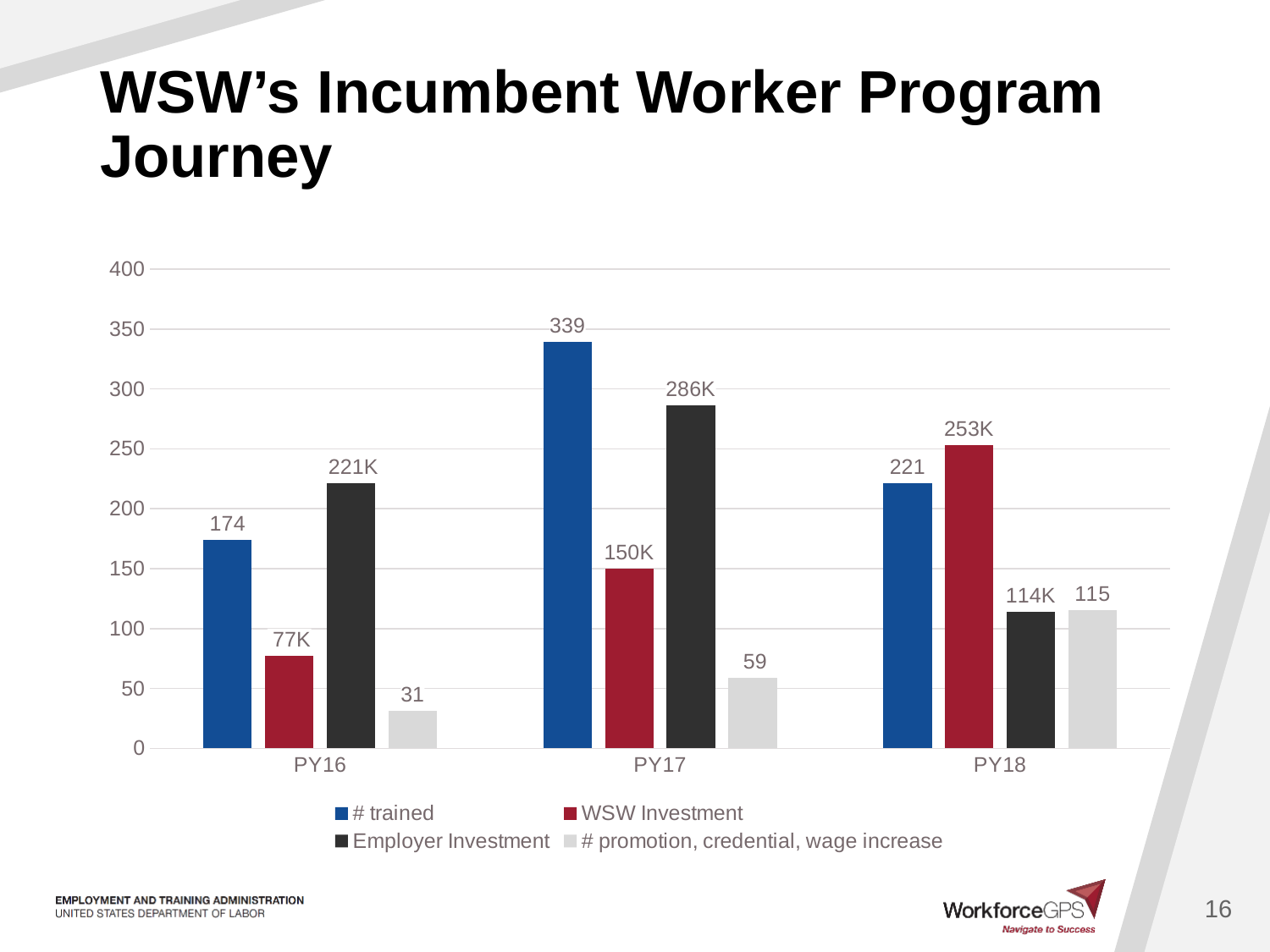
In which program year is the # promotion, credential, wage increase value lowest? PY16 What is the difference in # trained between PY17 and PY16? 165 How many program years are shown on the x axis? 3 What is the Employer Investment value for PY18? 114K What is the value for # trained in PY17? 339 Which is larger, the WSW Investment in PY18 or the Employer Investment in PY18? WSW Investment What is the WSW Investment value for PY16? 77K In which program year is the # trained value highest? PY17 What is the value for # promotion, credential, wage increase in PY18? 115 How many series does the legend list? 4 Does the # promotion, credential, wage increase value rise or fall from PY16 to PY18? Rise What kind of chart is shown on the slide? Bar chart